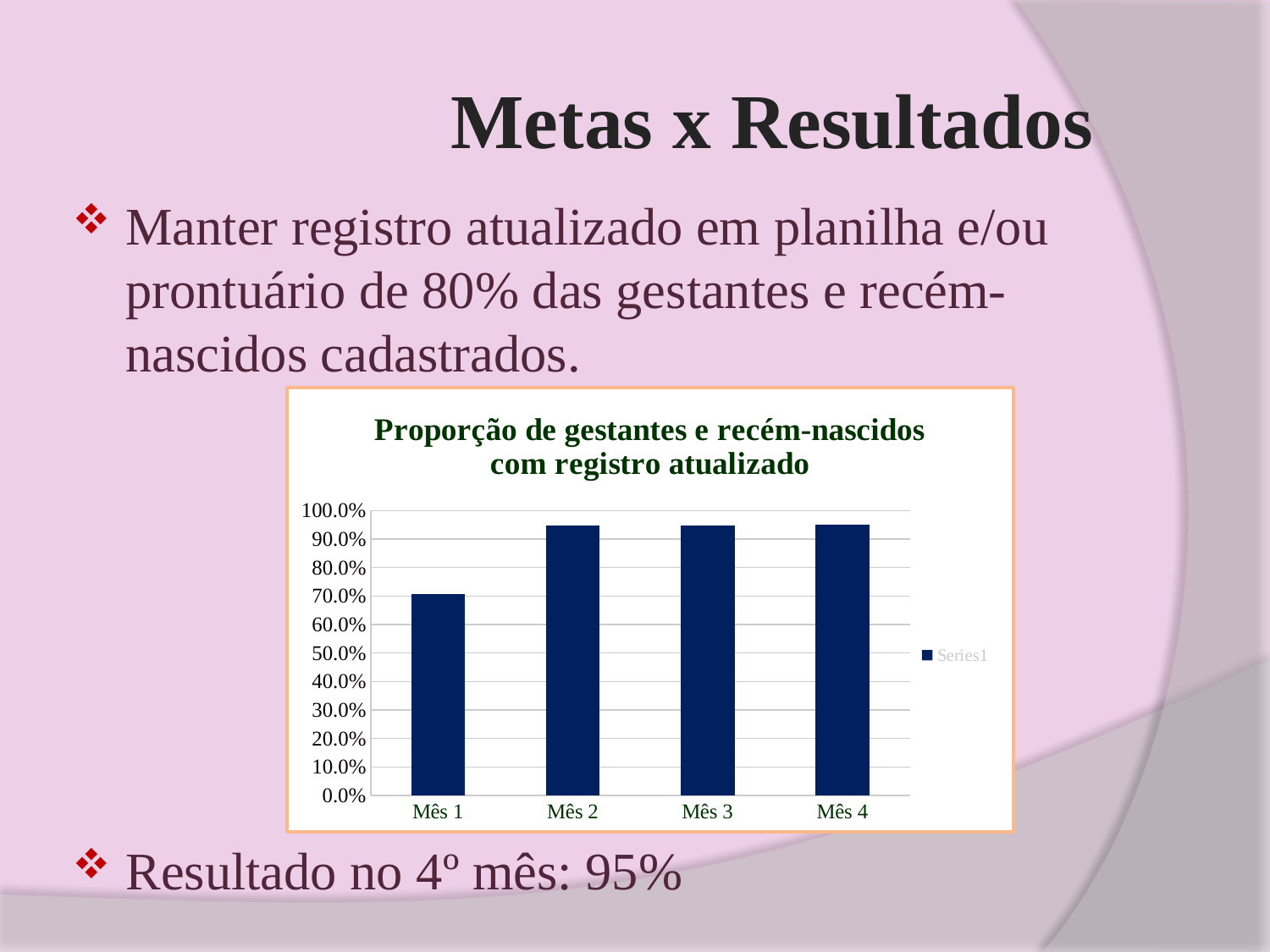
What kind of chart is shown on the slide? bar chart Is the value for Mês 4 greater or less than 80.0%? greater What is the title of the chart? Proporção de gestantes e recém-nascidos com registro atualizado Is the value for Mês 1 greater or less than 80.0%? less How many series does the chart legend list? 1 What is the name of the series shown in the chart legend? Series1 Is the value for Mês 1 greater or less than 60.0%? greater Does the value rise or fall from Mês 1 to Mês 2? rise How many categories (months) are shown on the x axis of the chart? 4 Which month has the lowest value in the chart? Mês 1 Which is larger, the value for Mês 1 or the value for Mês 2? Mês 2